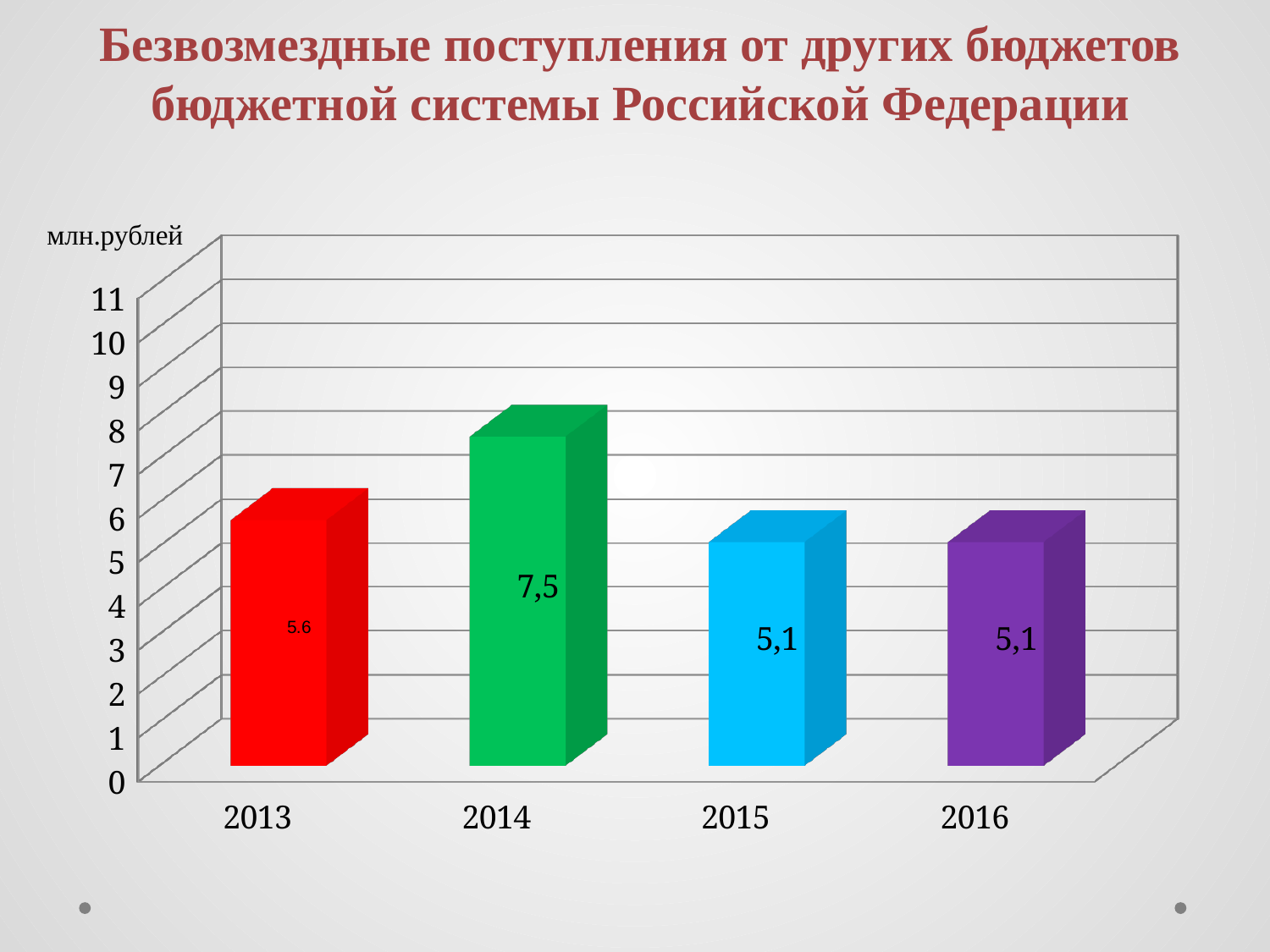
What is the difference between the values for 2014 and 2015? 2,4 What is the value for 2015? 5,1 What unit is shown on the vertical axis? млн.рублей What kind of chart is shown on the slide? bar chart Which year has the highest value? 2014 What is the value for 2016? 5,1 Is the value for 2014 greater or less than 7? greater What is the value for 2013? 5.6 Do the values rise or fall from 2014 to 2015? fall How many years are shown on the x axis? 4 What is the value for 2014? 7,5 Which is larger, the value for 2014 or the value for 2013? 2014